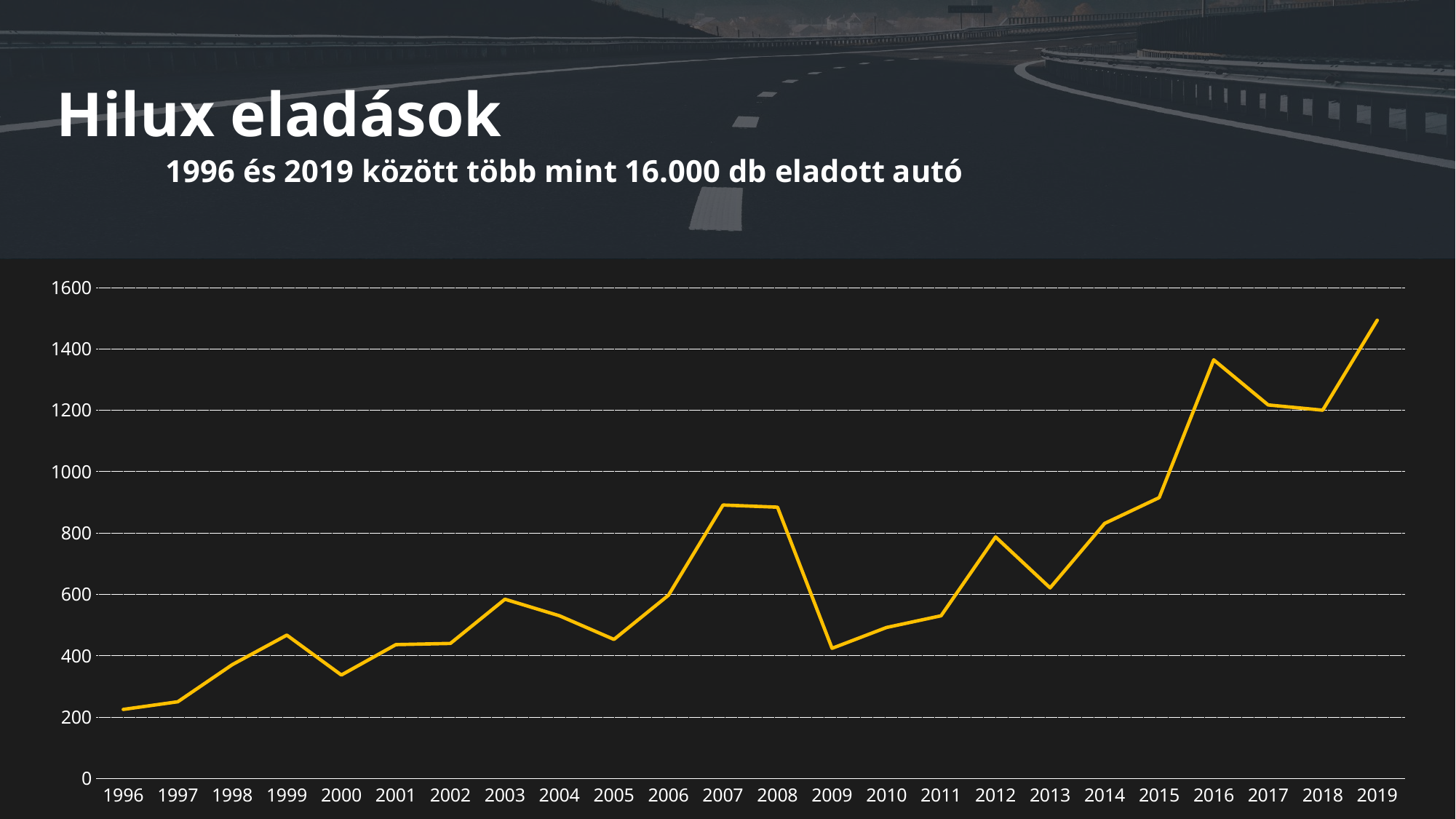
Overall, do the values rise or fall from 1996 to 2019? rise Is the value for 2000 greater or less than 400? less Is the value for 2016 greater or less than 1200? greater Which year has the larger value, 2007 or 2009? 2007 How many years are plotted along the x axis? 24 Which year has the larger value, 2016 or 2017? 2016 Is the value for 2019 greater or less than 1400? greater Which year has the lowest value? 1996 Which year has the highest value? 2019 What kind of chart is shown on the slide? line chart What is the title of the chart on the slide? Hilux eladások